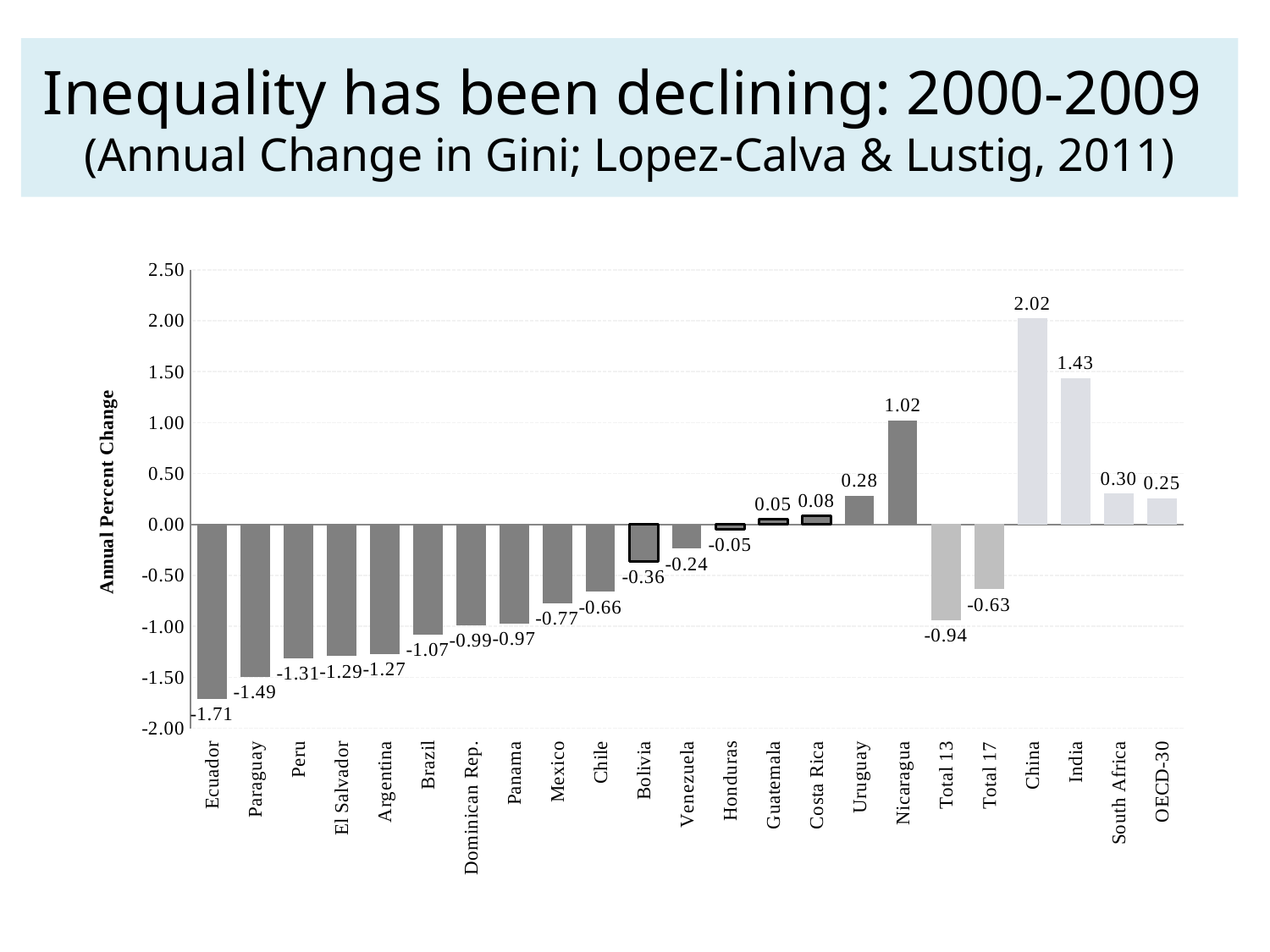
What value is shown for Total 17? -0.63 Which category has the lowest value on the chart? Ecuador Which has a larger value, South Africa or OECD-30? South Africa Is the value for Paraguay greater or less than -1.00? less What value is shown for China? 2.02 What value is shown for Nicaragua? 1.02 What is the label on the vertical axis of the chart? Annual Percent Change Which category has the highest value on the chart? China What is the difference between the values for China and India? 0.59 How many categories are plotted on the chart? 23 What kind of chart is shown on the slide? Bar chart What is the annual percent change in Gini shown for Ecuador? -1.71